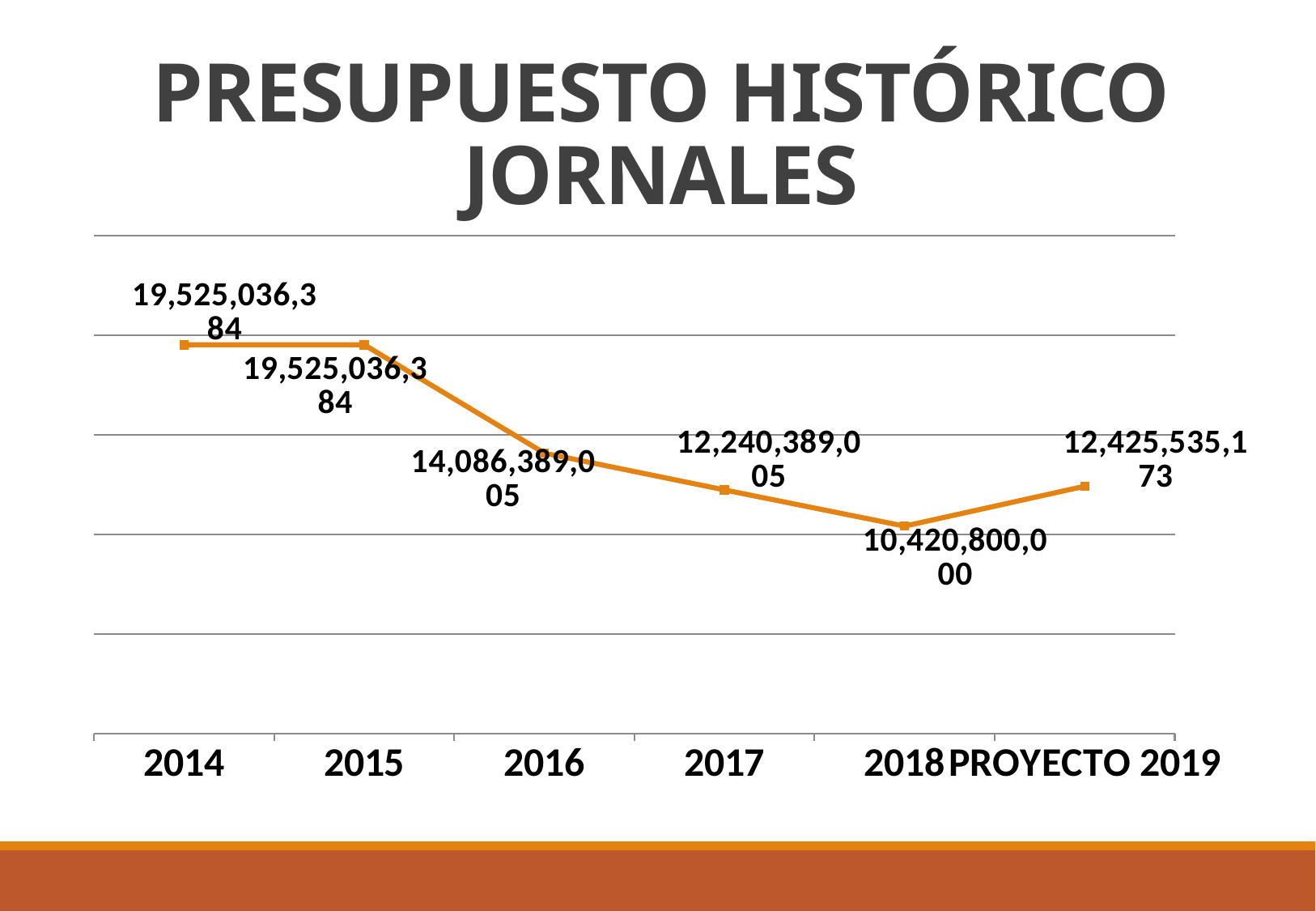
Which year has the lowest value? 2018 Which is larger, the value for 2016 or the value for 2017? 2016 What is the difference between the values for 2017 and 2018? 1,819,589,005 Which is larger, the value for 2018 or the value for PROYECTO 2019? PROYECTO 2019 What is the value for PROYECTO 2019? 12,425,535,173 What is the value for 2018? 10,420,800,000 What is the difference between the values for PROYECTO 2019 and 2018? 2,004,735,173 How many data points are plotted on the chart? 6 What is the value for 2014? 19,525,036,384 What kind of chart is shown on the slide? Line chart What is the value for 2016? 14,086,389,005 Do the values rise or fall from 2015 to 2018? Fall